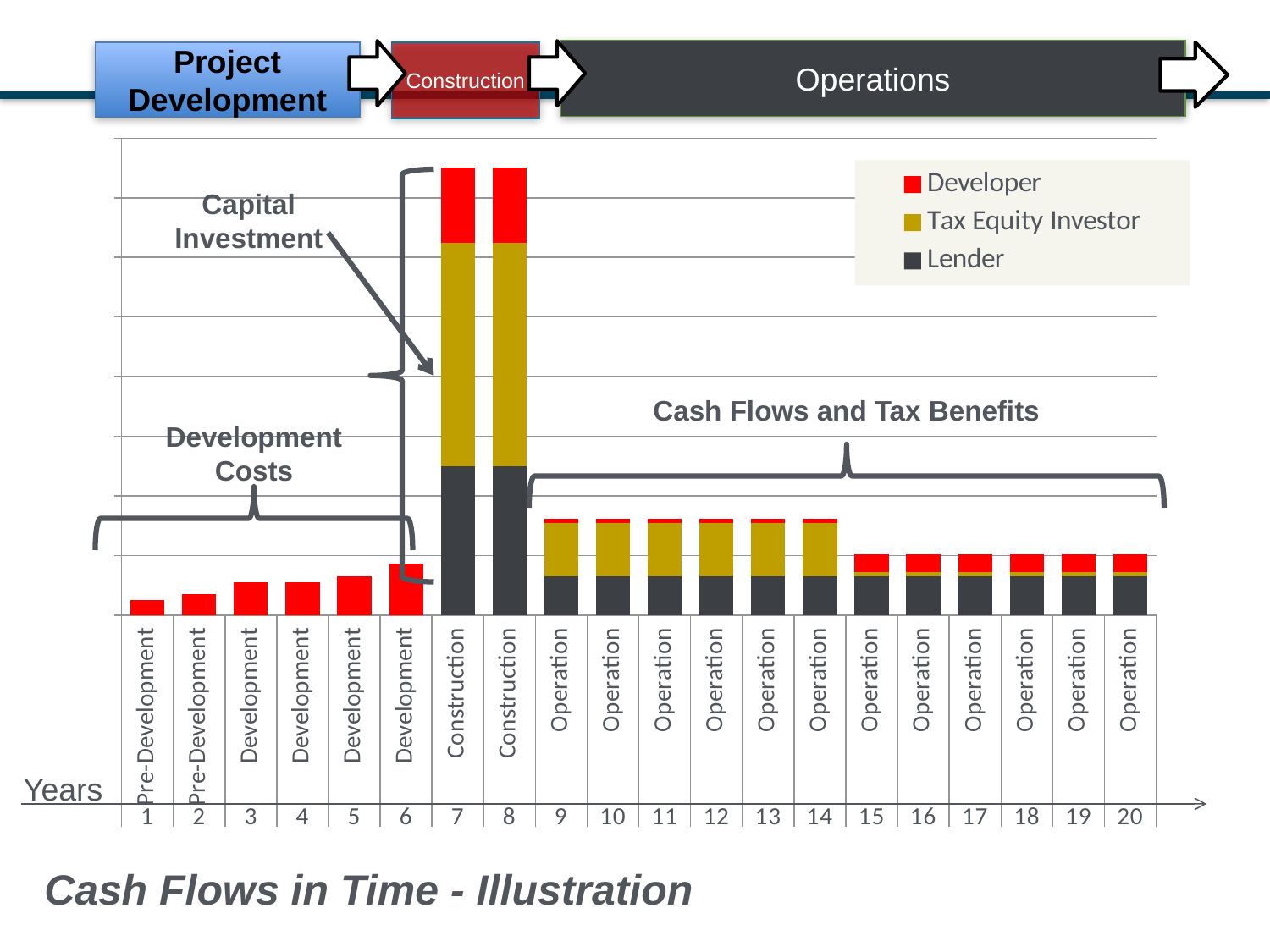
How many series does the legend list? 3 Which series is the only one present in the bars for years 1 to 6? Developer How many years (bars) are plotted along the x axis? 20 What kind of chart is shown on the slide? Stacked bar chart Which bar is taller, year 7 or year 9? Year 7 Which year has the shortest bar? Year 1 Are the bars for years 15 to 20 taller or shorter than the bars for years 9 to 14? Shorter Which years have the tallest bars? Years 7 and 8 Which series are listed in the legend? Developer, Tax Equity Investor, Lender Do the bars rise or fall from year 1 to year 6? Rise Which bar is taller, year 6 or year 1? Year 6 Which phase label is shown for years 7 and 8? Construction